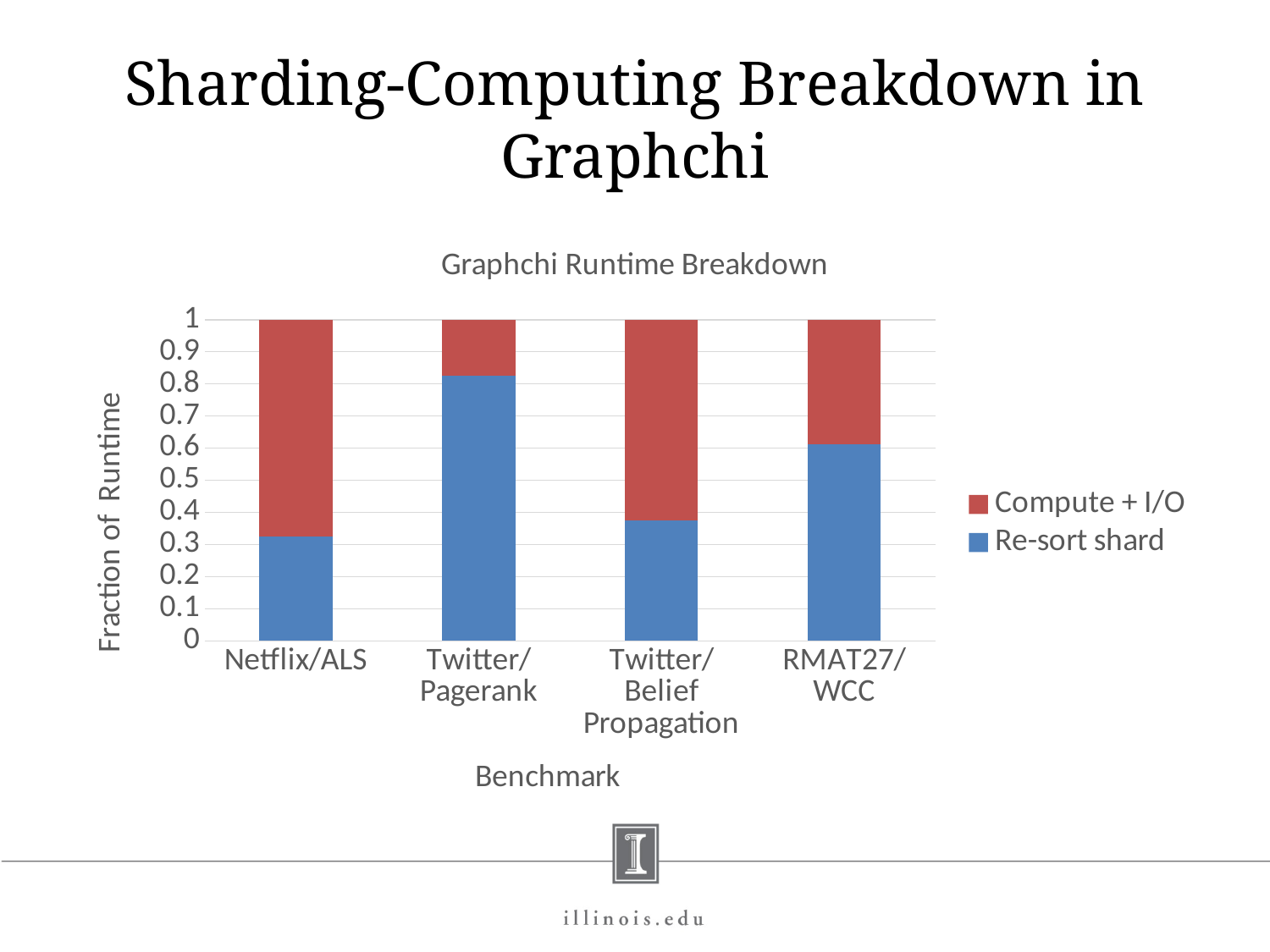
Is the Re-sort shard fraction for Netflix/ALS greater or less than 0.4? less What is the label of the y axis? Fraction of Runtime Is the Re-sort shard fraction for RMAT27/WCC greater or less than 0.5? greater How many series does the chart's legend list? 2 Is the Re-sort shard fraction for Twitter/Belief Propagation greater or less than 0.5? less What kind of chart is shown on the slide? bar chart What is the total height of the stacked bar for Netflix/ALS? 1 What is the title of the chart? Graphchi Runtime Breakdown How many benchmarks are shown on the x axis of the chart? 4 Which benchmark has the largest Re-sort shard fraction? Twitter/Pagerank Which has a larger Re-sort shard fraction, Twitter/Pagerank or RMAT27/WCC? Twitter/Pagerank